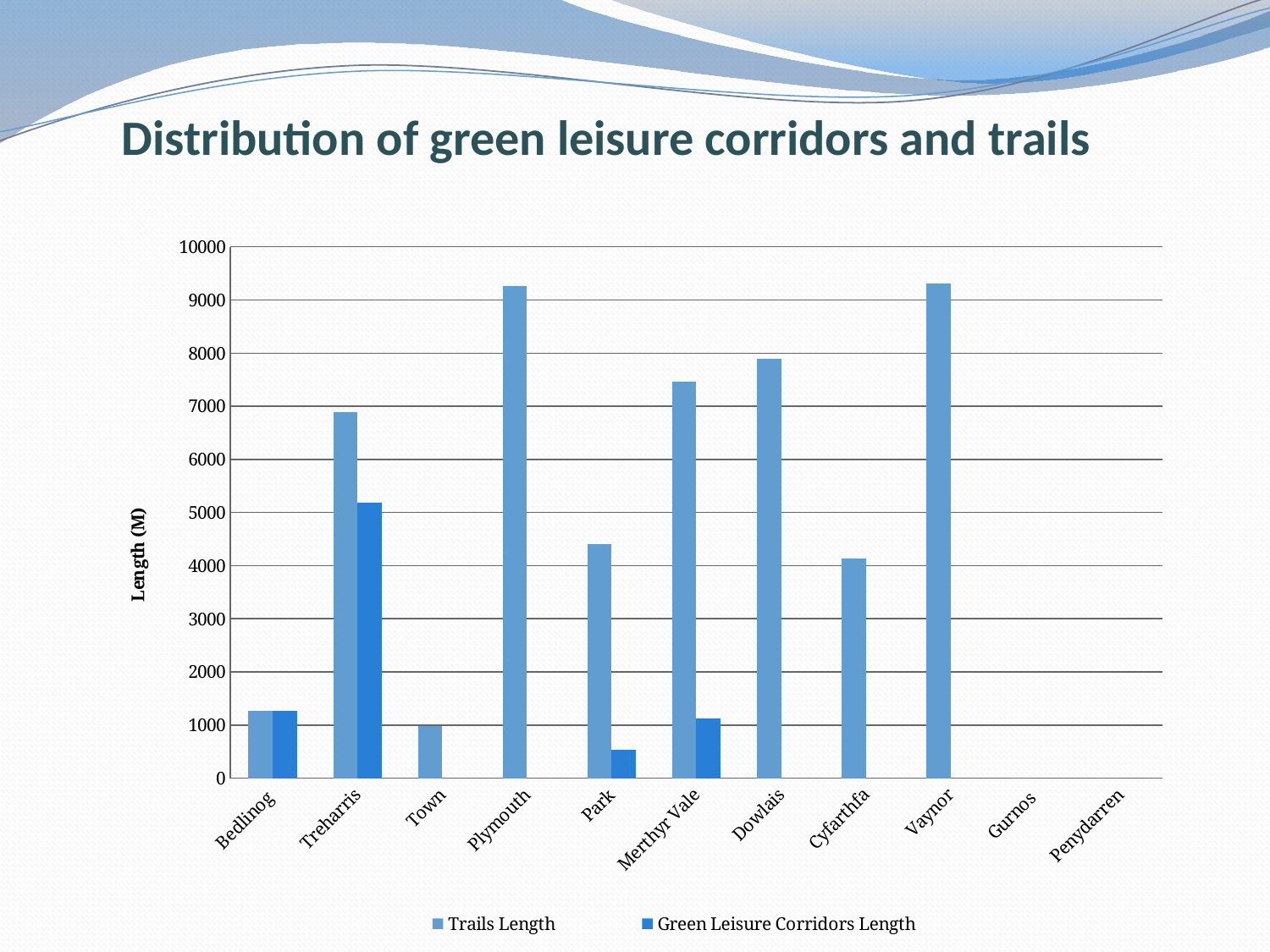
Is the Trails Length for Treharris greater or less than 6000? greater Is the Green Leisure Corridors Length for Treharris greater or less than 4000? greater Is the Trails Length for Plymouth greater or less than 9000? greater How many series does the legend list? 2 How many categories are shown on the x axis? 11 Which category has the highest Green Leisure Corridors Length? Treharris What kind of chart is shown on the slide? bar chart Which has the larger Green Leisure Corridors Length, Treharris or Park? Treharris Which has the larger Trails Length, Dowlais or Merthyr Vale? Dowlais What is the label on the vertical axis? Length (M)